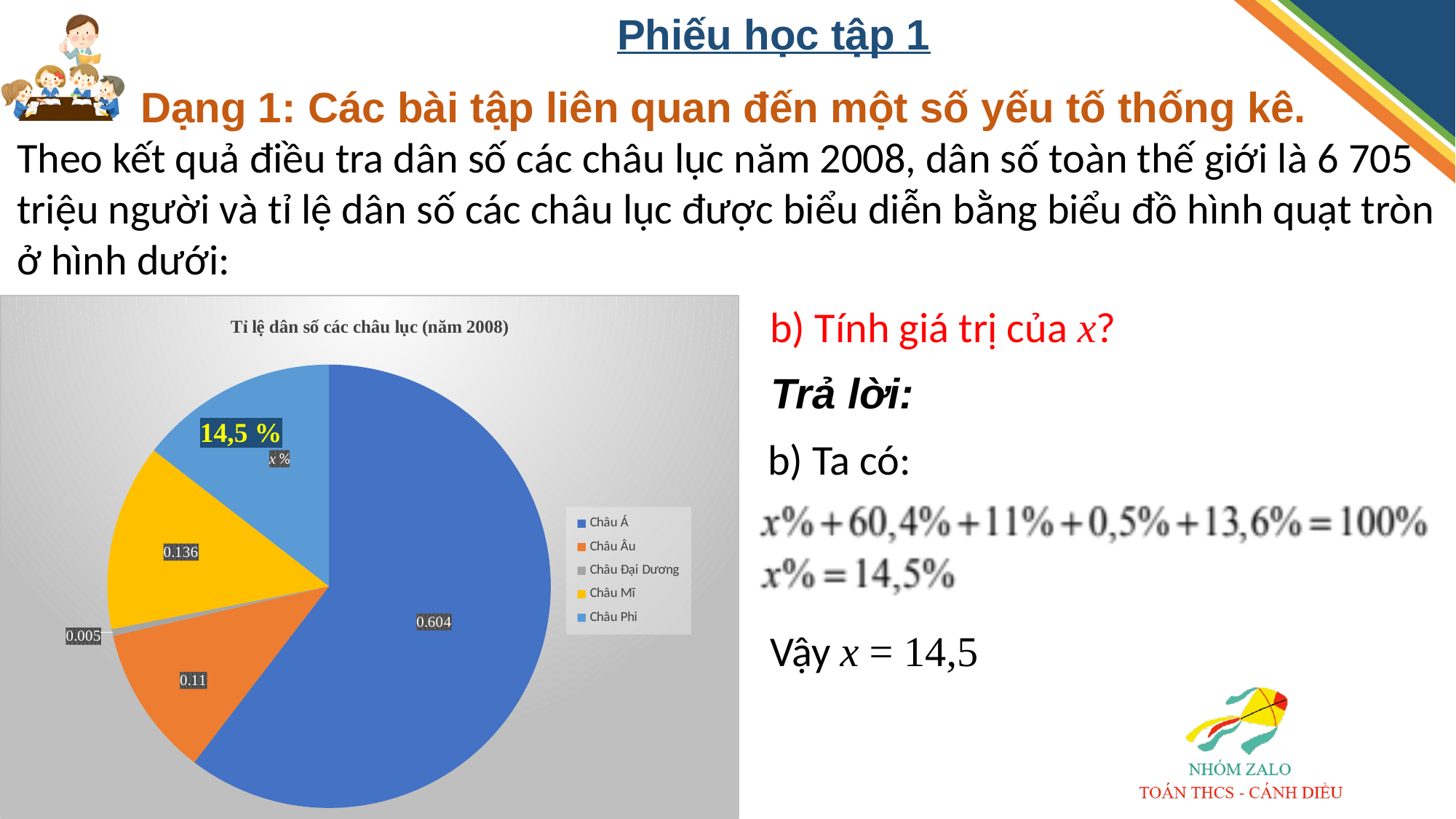
How many categories does the pie chart have? 5 How many entries does the legend list? 5 Which is larger, the value for Châu Mĩ or the value for Châu Âu? Châu Mĩ What is the value shown for Châu Đại Dương? 0.005 What is the title of the chart? Tỉ lệ dân số các châu lục (năm 2008) What is the value shown for Châu Âu? 0.11 Which category has the largest slice of the pie? Châu Á Which category has the smallest slice of the pie? Châu Đại Dương What kind of chart is shown on the slide? pie chart What is the value shown for Châu Á? 0.604 What is the difference between the values for Châu Á and Châu Mĩ? 0.468 What is the value shown for Châu Mĩ? 0.136